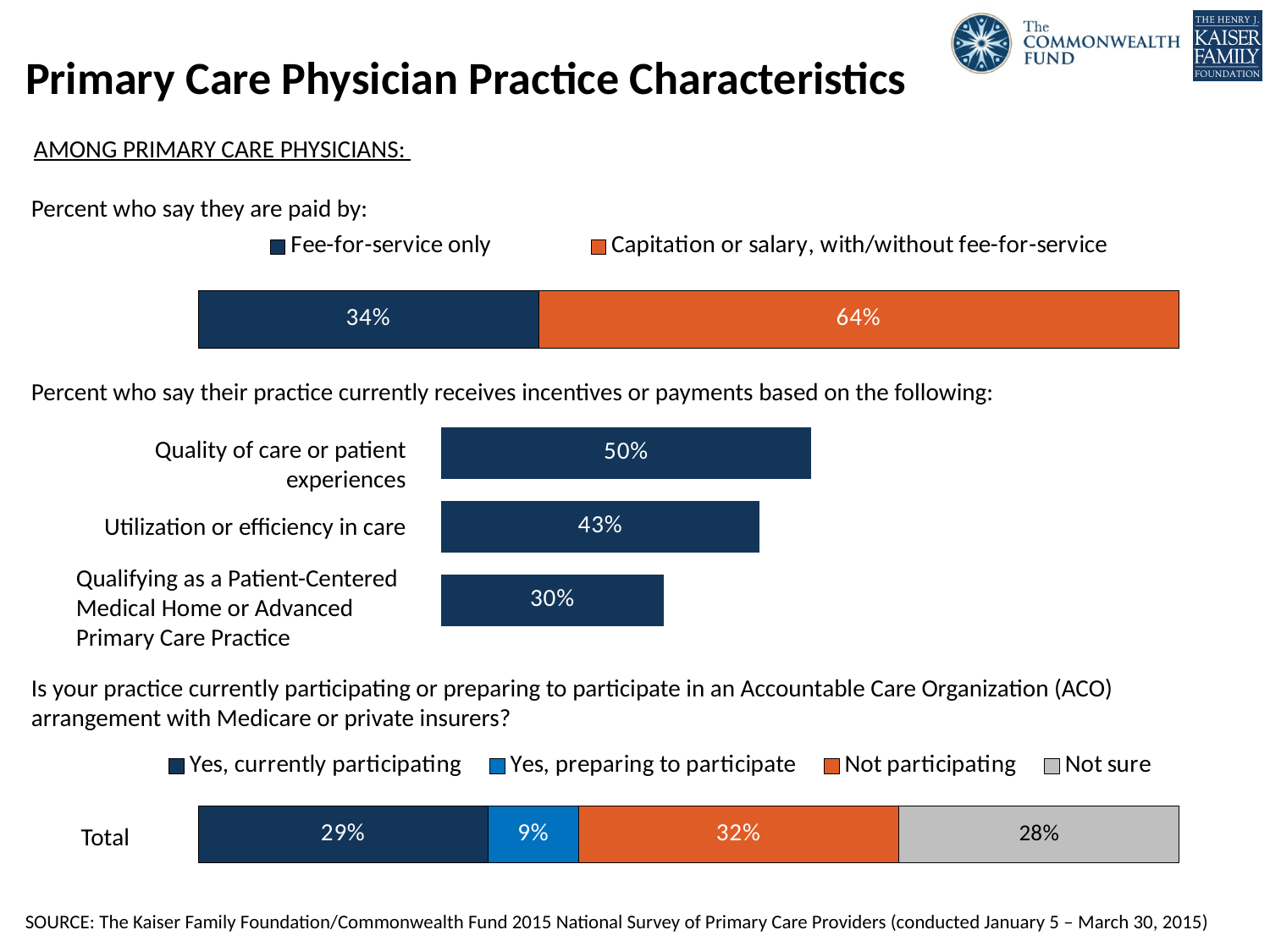
In the middle chart on incentives or payments, how many categories are shown? 3 In the bottom chart on ACO participation, how many series does the legend list? 4 In the middle chart on incentives or payments, what is the difference between the values for quality of care or patient experiences and utilization or efficiency in care? 7 percentage points In the bottom chart on ACO participation, what percent say they are currently participating? 29% In the top chart on physician payment, how many series does the legend list? 2 In the bottom chart on ACO participation, which is larger: not participating or not sure? Not participating In the middle chart on incentives or payments, what percent say their practice receives incentives based on quality of care or patient experiences? 50% In the middle chart on incentives or payments, what percent say their practice receives incentives based on utilization or efficiency in care? 43% What kind of chart is the middle chart on incentives or payments? Bar chart In the top chart on physician payment, what percent say they are paid by capitation or salary, with/without fee-for-service? 64% In the top chart on physician payment, what percent say they are paid by fee-for-service only? 34% In the middle chart on incentives or payments, which category has the lowest value? Qualifying as a Patient-Centered Medical Home or Advanced Primary Care Practice